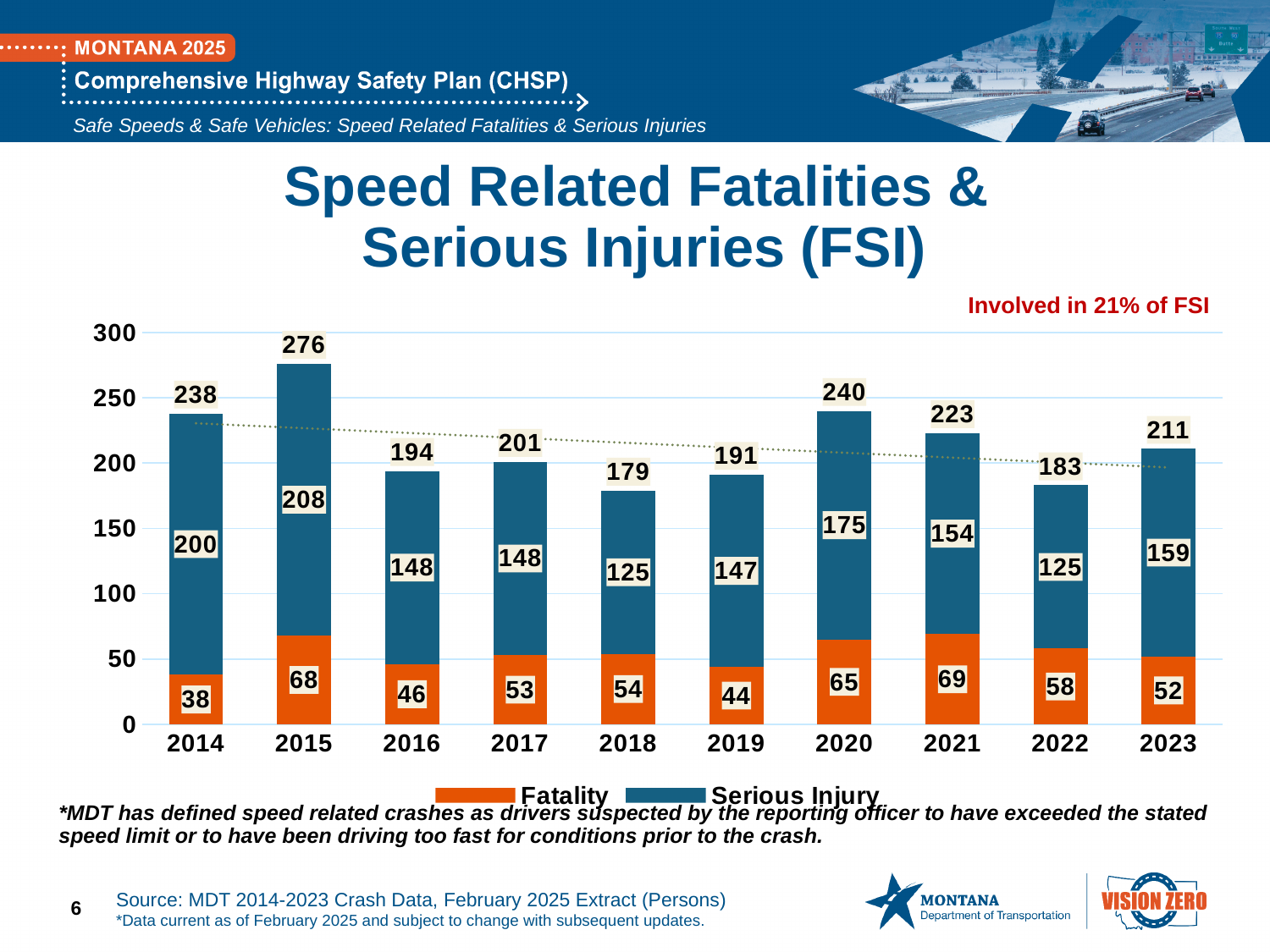
What percentage of FSI does the slide say speed is involved in? 21% What is the Serious Injury value for 2018? 125 What is the total of the stacked bar for 2020? 240 Which year has the lowest total speed related FSI? 2018 What is the difference between the Serious Injury values for 2015 and 2016? 60 How many series does the legend list? 2 Which is larger, the Fatality value for 2019 or for 2022? 2022 What type of chart is shown on the slide? Stacked bar chart How many years are shown on the x axis? 10 What is the Fatality value for 2021? 69 Which year has the highest total speed related FSI? 2015 Is the total for 2023 greater or less than 200? greater